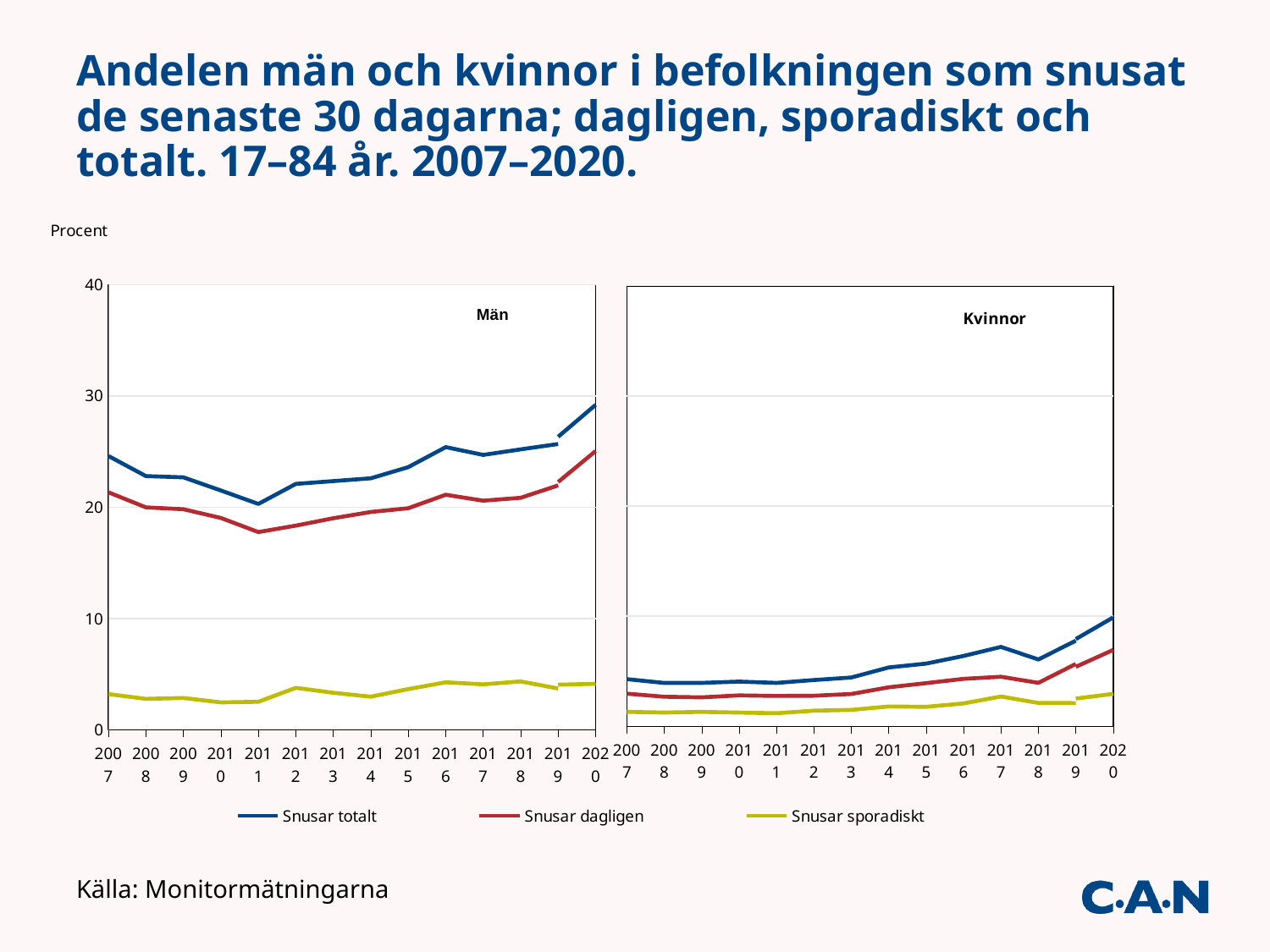
In the Män chart, is the value for Snusar dagligen in 2011 greater or less than 20? less How many series does the legend list? 3 In the Kvinnor chart, is the value for Snusar totalt in 2007 greater or less than 10? less In the Män chart, how many years are plotted along the x axis? 14 In the Kvinnor chart, in which year is Snusar totalt highest? 2020 In the Män chart, in which year is Snusar totalt highest? 2020 What label is shown on the y axis above the charts? Procent In the Kvinnor chart, does Snusar totalt rise or fall from 2007 to 2020? Rise What kind of chart is used on the slide for the Män and Kvinnor panels? Line chart In the Män chart, in which year is Snusar dagligen lowest? 2011 In the Män chart, is the value for Snusar totalt in 2020 greater or less than 20? greater Which is larger in 2020: Snusar totalt in the Män chart or Snusar totalt in the Kvinnor chart? Män